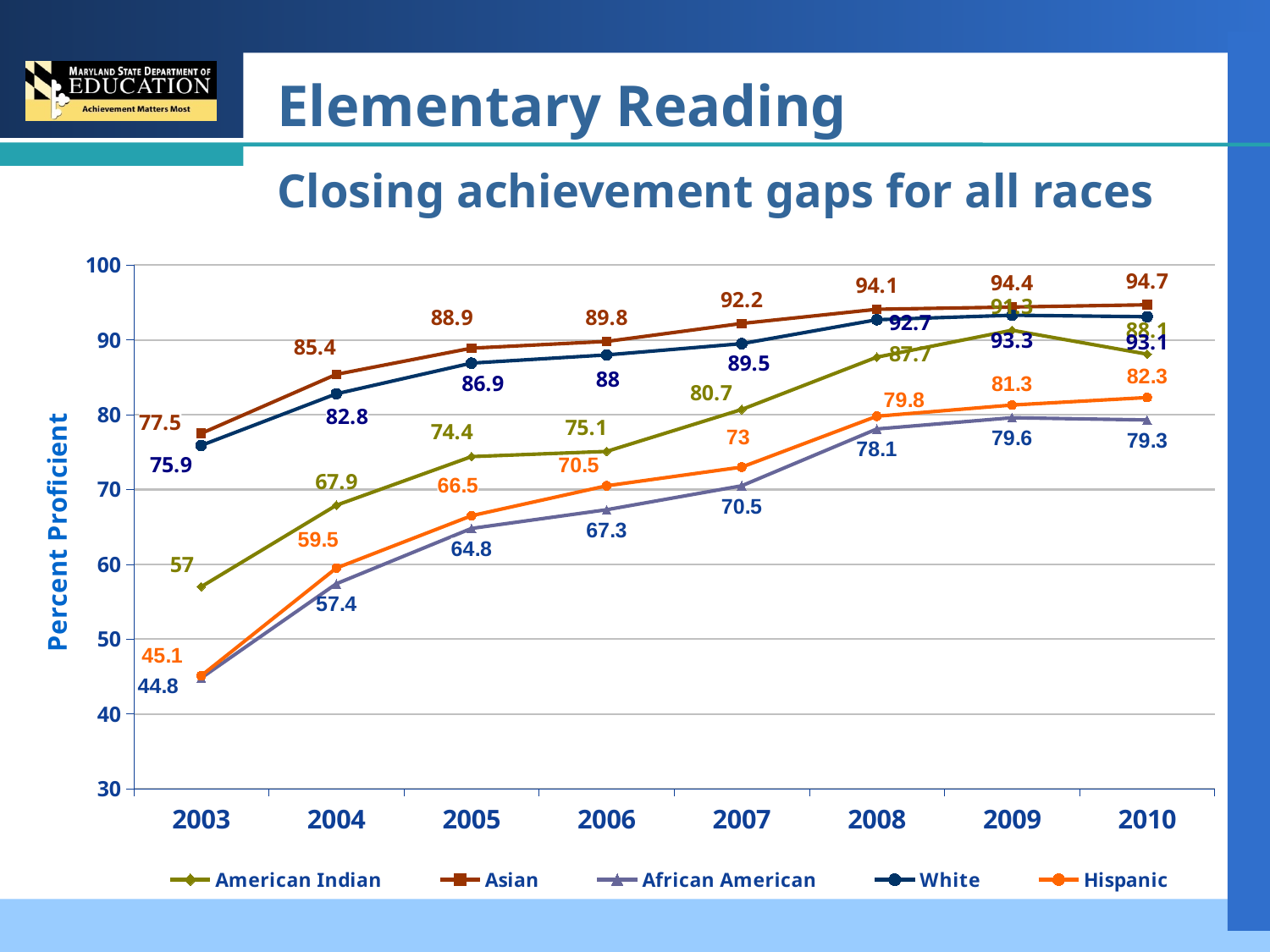
What was the percent proficient for Hispanic students in 2003? 45.1 What was the percent proficient for Asian students in 2010? 94.7 How many years are shown on the x axis? 8 Which group had the lowest percent proficient in 2003? African American Does the Hispanic series rise or fall from 2003 to 2010? rise What kind of chart is shown on the slide? line chart What was the percent proficient for White students in 2008? 92.7 What was the percent proficient for African American students in 2006? 67.3 How many series does the legend list? 5 In 2005, which was larger: the American Indian value or the Hispanic value? American Indian What is the difference between the Asian and African American values in 2003? 32.7 Which group had the highest percent proficient in 2007? Asian